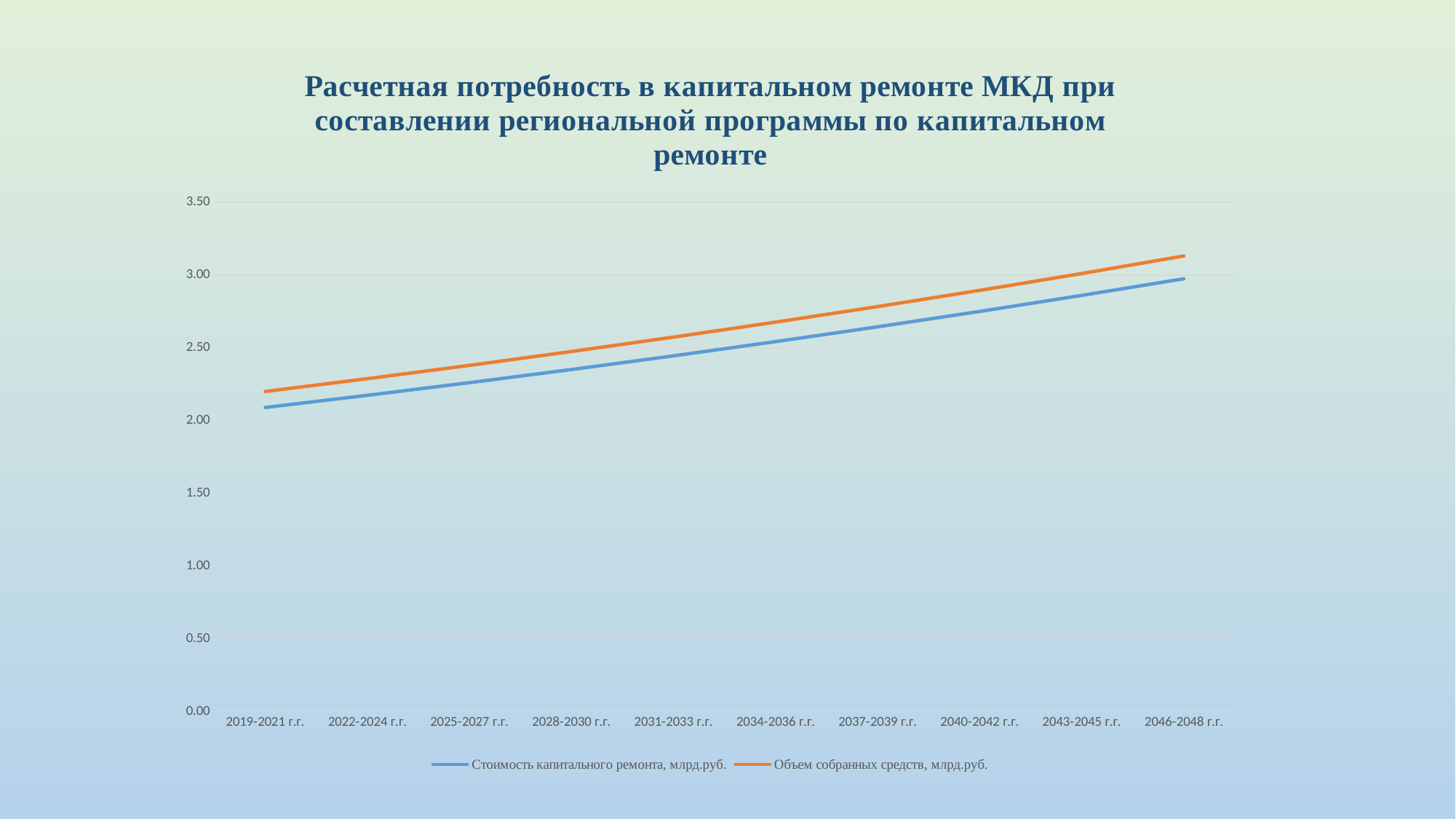
What kind of chart is shown on the slide? Line chart How many periods are shown along the x axis? 10 In which period is the value of "Объем собранных средств, млрд.руб." highest? 2046-2048 г.г. Which series has the larger value in 2034-2036 г.г., "Стоимость капитального ремонта, млрд.руб." or "Объем собранных средств, млрд.руб."? Объем собранных средств, млрд.руб. How many series does the legend list? 2 What is the first legend entry of the chart? Стоимость капитального ремонта, млрд.руб. Is the value of "Объем собранных средств, млрд.руб." for 2019-2021 г.г. greater or less than 2.00? greater Do the values of the series "Стоимость капитального ремонта, млрд.руб." rise or fall from 2019-2021 г.г. to 2046-2048 г.г.? Rise Is the value of "Объем собранных средств, млрд.руб." for 2046-2048 г.г. greater or less than 3.00? greater Is the value of "Стоимость капитального ремонта, млрд.руб." for 2037-2039 г.г. greater or less than 2.50? greater Which colour is used for the series "Объем собранных средств, млрд.руб."? Orange In which period is the value of "Стоимость капитального ремонта, млрд.руб." lowest? 2019-2021 г.г.